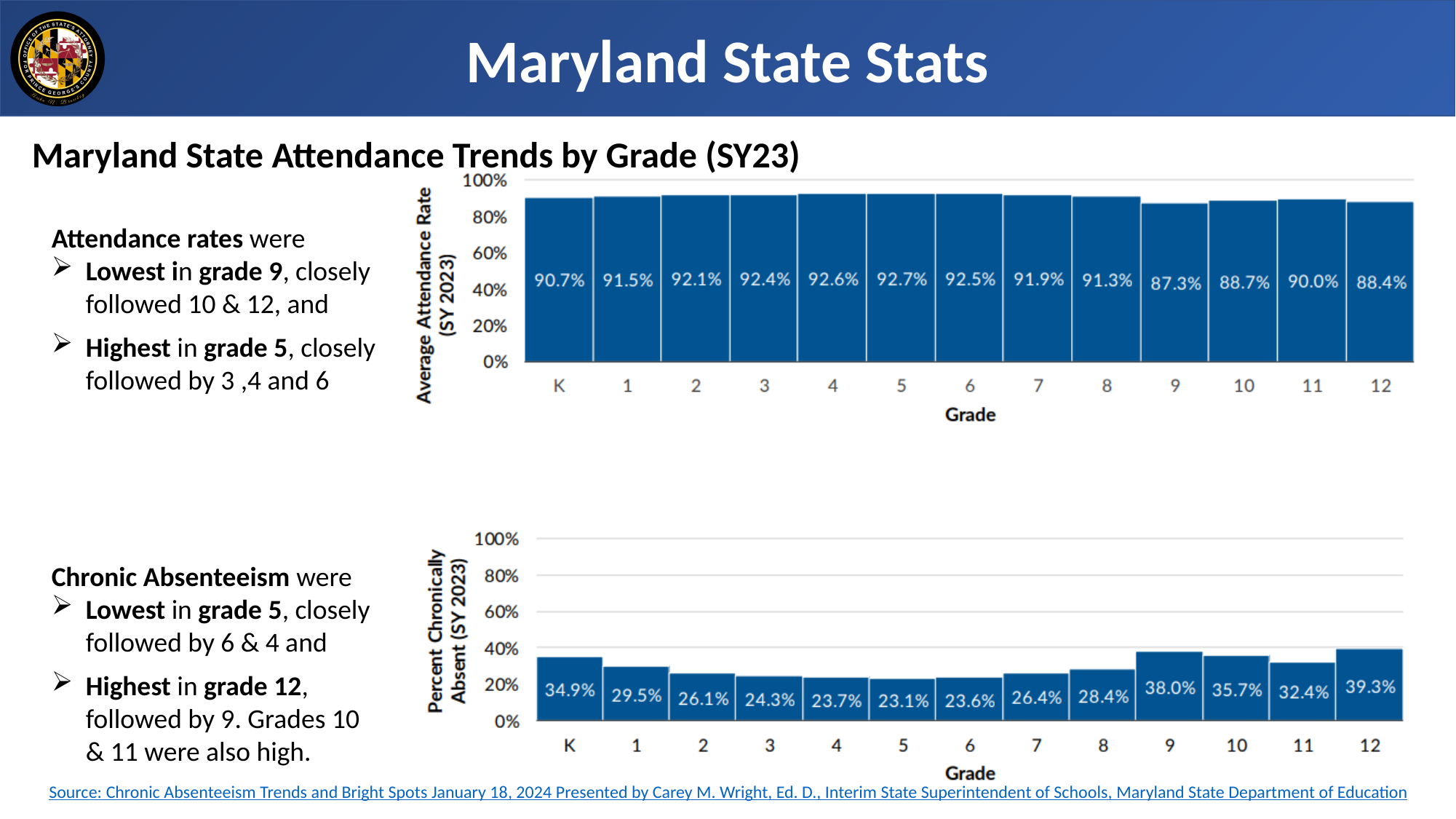
In the top chart (Average Attendance Rate), which grade has the highest attendance rate? 5 What kind of chart is the top chart (Average Attendance Rate)? bar chart In the top chart (Average Attendance Rate), which grade has the lowest attendance rate? 9 In the top chart (Average Attendance Rate), what is the difference between the values for grade 5 and grade 9? 5.4% In the bottom chart (Percent Chronically Absent), what is the value for grade 8? 28.4% In the top chart (Average Attendance Rate), what is the value for grade K? 90.7% In the bottom chart (Percent Chronically Absent), which grade has the lowest value? 5 In the bottom chart (Percent Chronically Absent), which grade has the highest value? 12 How many grade categories are shown in the bottom chart (Percent Chronically Absent)? 13 In the bottom chart (Percent Chronically Absent), which is larger, the value for grade 9 or grade 10? grade 9 In the bottom chart (Percent Chronically Absent), what is the value for grade 12? 39.3% In the top chart (Average Attendance Rate), what is the value for grade 5? 92.7%